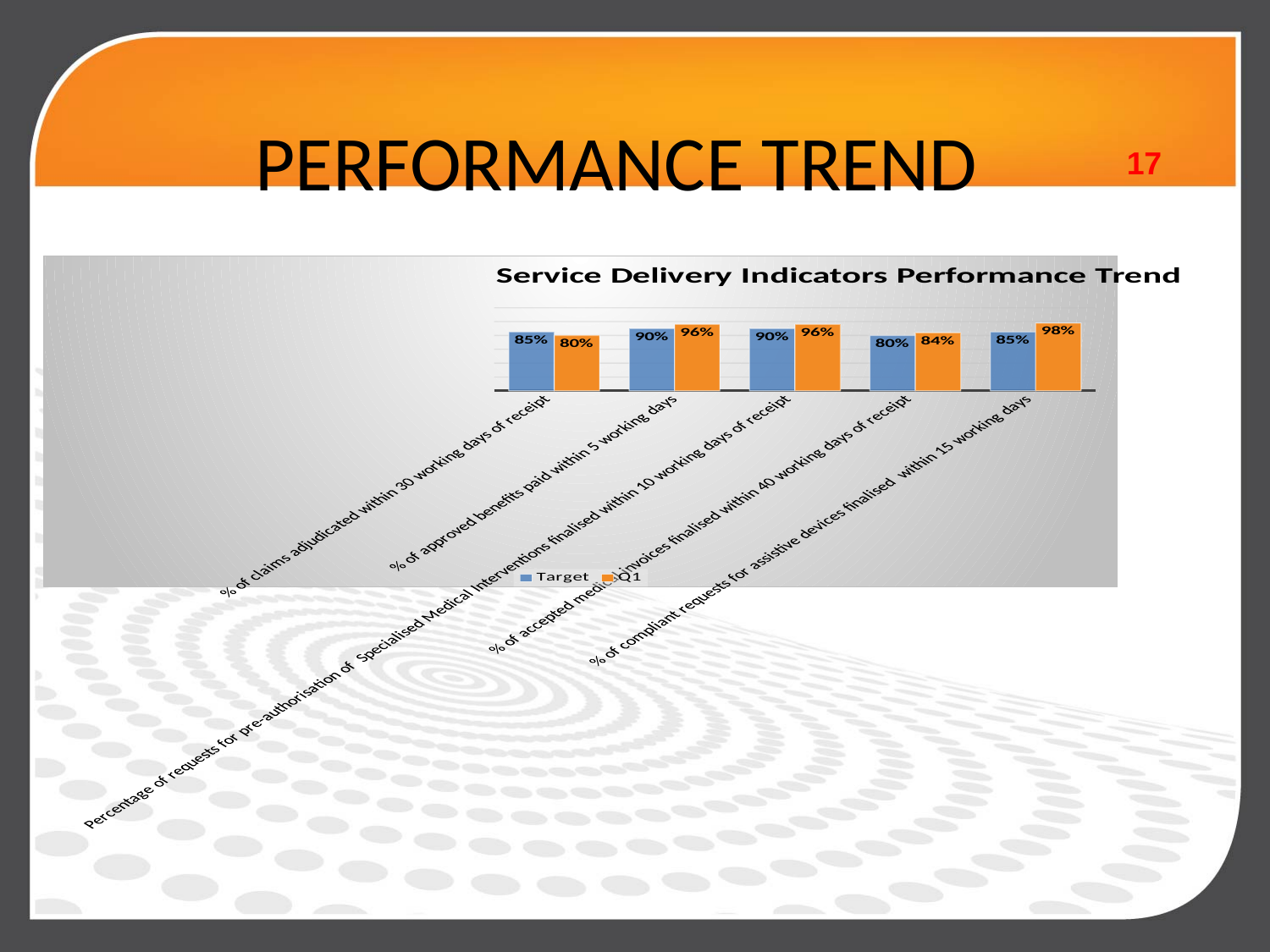
How many series does the legend list? 2 What kind of chart is shown on the slide? Bar chart What is the Target value for '% of approved benefits paid within 5 working days'? 90% How many categories are shown on the x axis of the chart? 5 What is the title of the chart? Service Delivery Indicators Performance Trend Which category has the highest Q1 value? % of compliant requests for assistive devices finalised within 15 working days Which category has the lowest Q1 value? % of claims adjudicated within 30 working days of receipt What is the Target value for '% of accepted medical invoices finalised within 40 working days of receipt'? 80% What is the difference between the Q1 value and the Target value for '% of compliant requests for assistive devices finalised within 15 working days'? 13% For '% of claims adjudicated within 30 working days of receipt', which is larger, the Target or the Q1 value? Target What is the Q1 value for '% of compliant requests for assistive devices finalised within 15 working days'? 98% What is the Q1 value for '% of claims adjudicated within 30 working days of receipt'? 80%